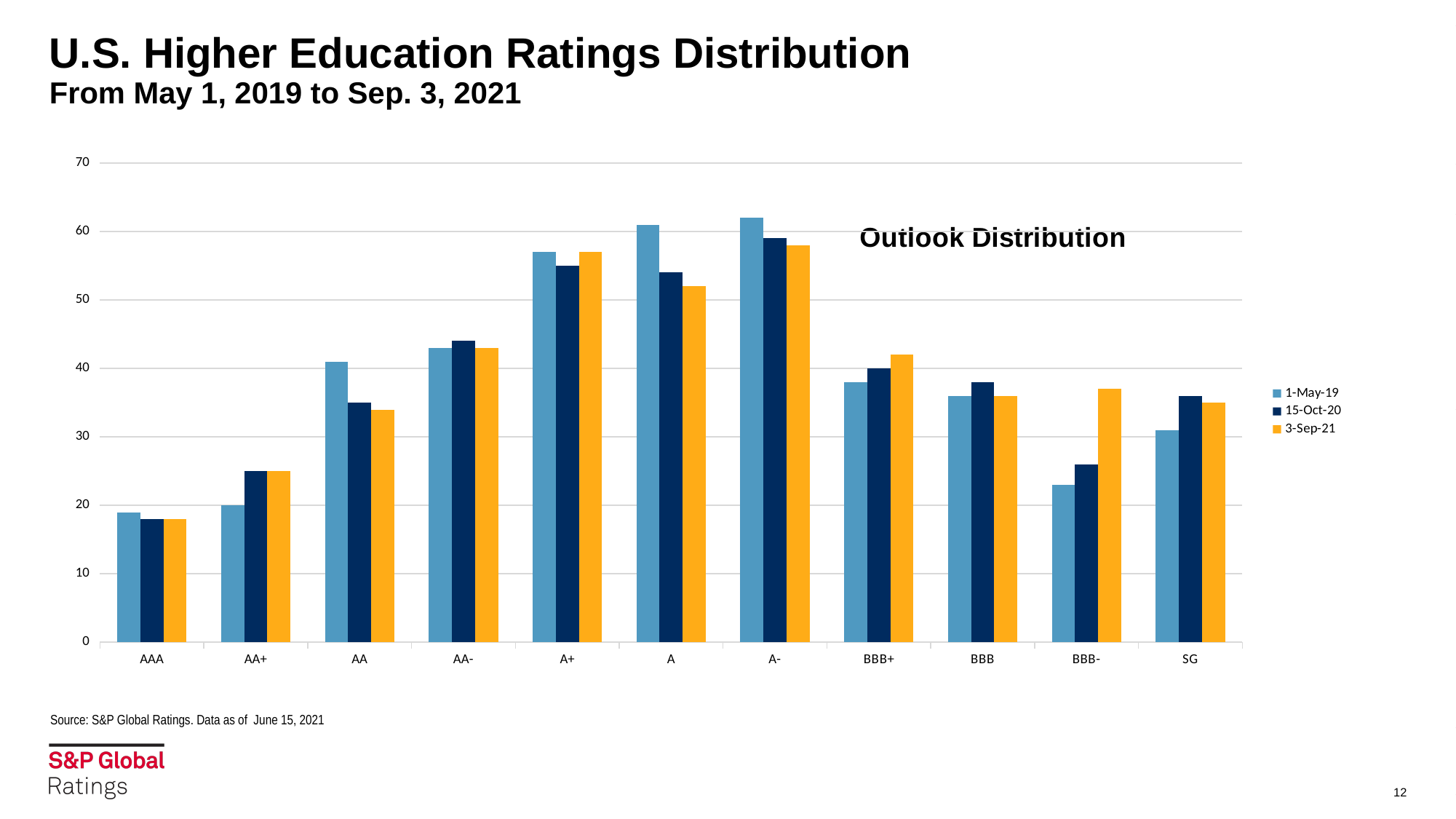
Which series is shown in orange in the legend? 3-Sep-21 How many rating categories are shown on the x axis? 11 How many series does the legend list? 3 Which rating category has the highest 1-May-19 value? A- For the BBB- category, which series has the larger value: 1-May-19 or 3-Sep-21? 3-Sep-21 Which rating category has the lowest 3-Sep-21 value? AAA Is the 3-Sep-21 value for A- greater or less than 50? greater Do the 1-May-19 values rise or fall from AAA to A-? rise Is the 15-Oct-20 value for AA greater or less than 40? less What kind of chart is shown on the slide? bar chart Is the 1-May-19 value for BBB- greater or less than 30? less For the AA category, which series has the larger value: 1-May-19 or 3-Sep-21? 1-May-19